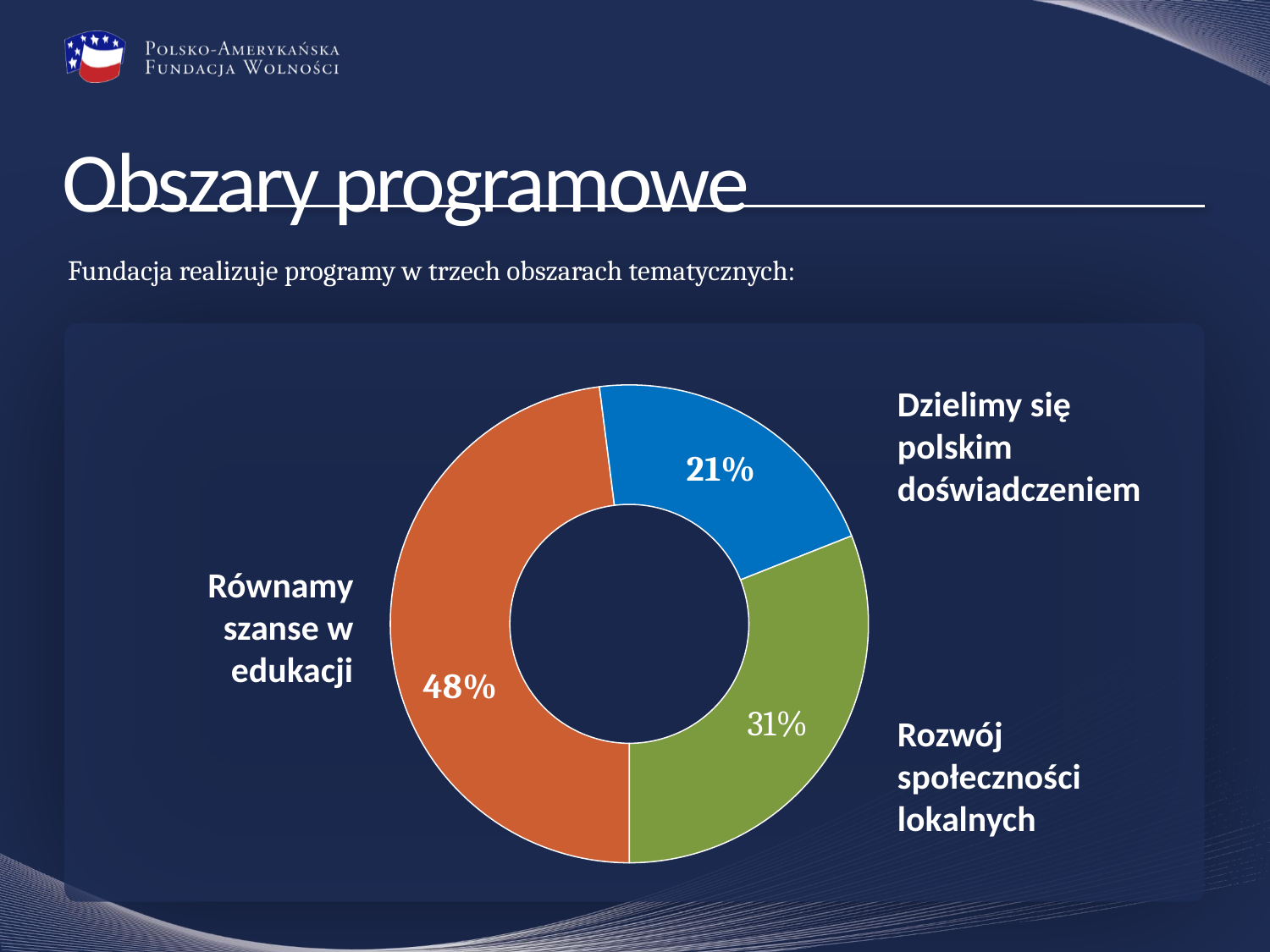
What kind of chart is shown on the slide? Doughnut (pie) chart Which is larger: the share for "Rozwój społeczności lokalnych" or the share for "Dzielimy się polskim doświadczeniem"? Rozwój społeczności lokalnych How many programme areas (slices) does the chart show? 3 What colour is the slice for "Równamy szanse w edukacji"? Orange What share of the chart does "Równamy szanse w edukacji" represent? 48% What is the title of the slide containing the chart? Obszary programowe Which programme area has the largest share? Równamy szanse w edukacji What share of the chart does "Rozwój społeczności lokalnych" represent? 31% Which programme area has the smallest share? Dzielimy się polskim doświadczeniem What is the difference in percentage points between "Rozwój społeczności lokalnych" and "Dzielimy się polskim doświadczeniem"? 10 percentage points What share of the chart does "Dzielimy się polskim doświadczeniem" represent? 21% What is the difference in percentage points between "Równamy szanse w edukacji" and "Rozwój społeczności lokalnych"? 17 percentage points